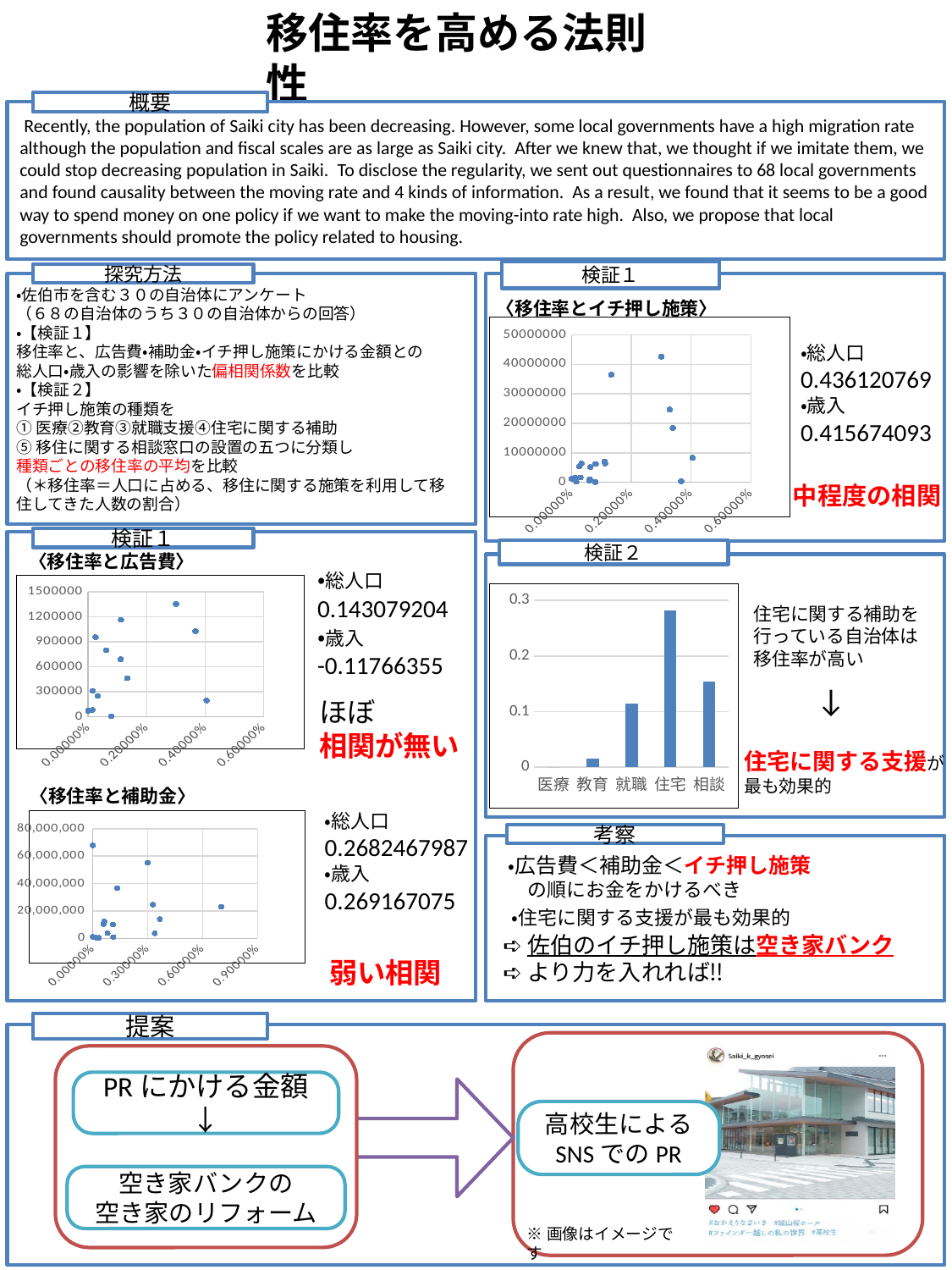
What kind of chart is the 〈移住率と広告費〉 chart? scatter plot How many categories are shown in the 検証2 bar chart? 5 In the 検証2 bar chart, which is larger, the value for 住宅 or the value for 就職? 住宅 In the 検証2 bar chart, which is larger, the value for 就職 or the value for 相談? 相談 In the 検証2 bar chart, is the value for 相談 greater or less than 0.2? less In the 検証2 bar chart, which category has the lowest value? 医療 In the 検証2 bar chart, which category has the highest value? 住宅 In the 検証2 bar chart, is the value for 住宅 greater or less than 0.2? greater In the 検証2 bar chart, is the value for 教育 greater or less than 0.1? less What is the highest y-axis tick value shown on the 〈移住率とイチ押し施策〉 chart? 50000000 What kind of chart is the 検証2 chart with categories 医療, 教育, 就職, 住宅, 相談? bar chart What is the highest y-axis tick value shown on the 〈移住率と補助金〉 chart? 80,000,000